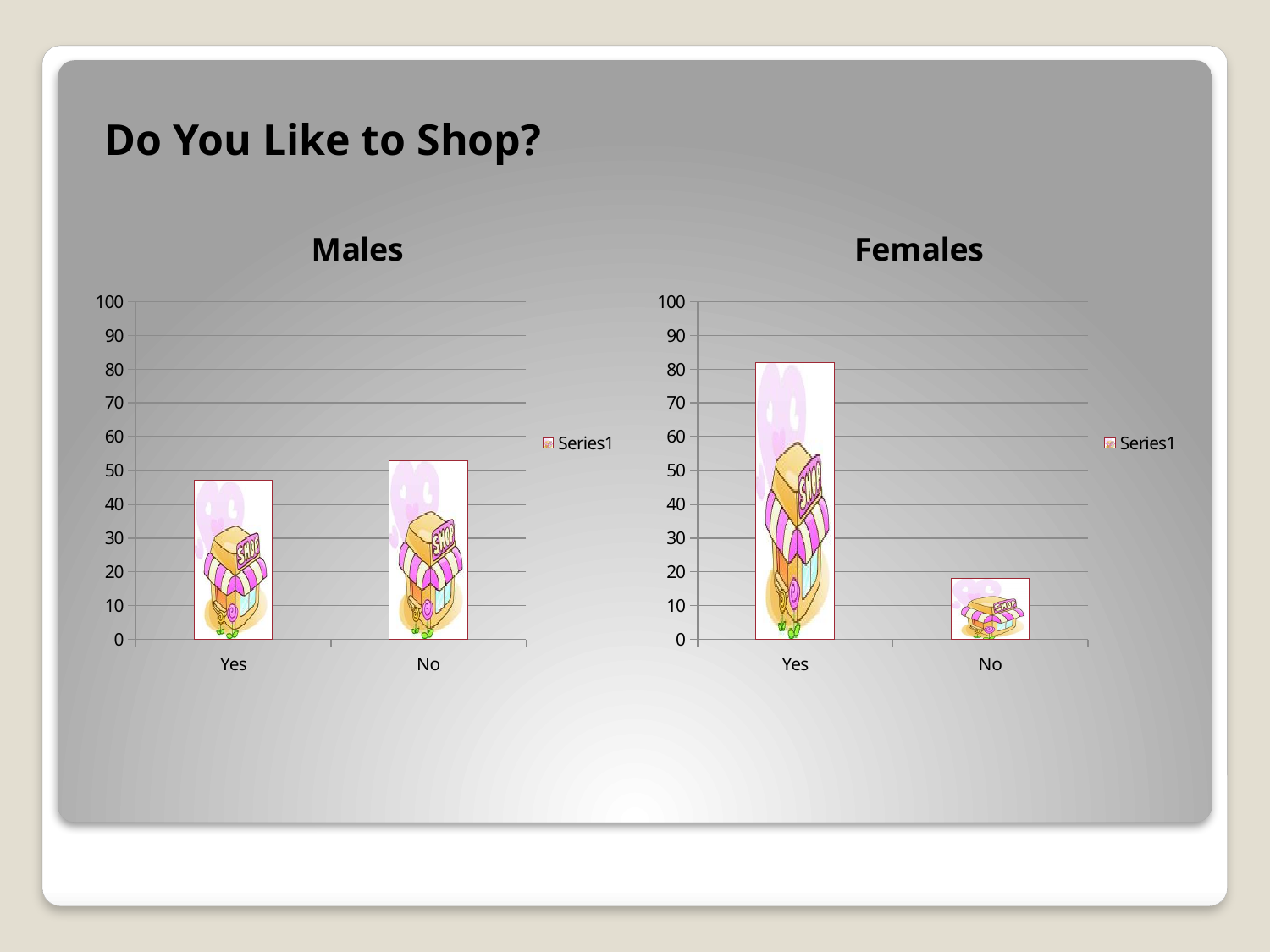
On the Females chart, which category has the lowest value? No What kind of chart is the Females chart? bar chart On the Males chart, is the value for No greater or less than 40? greater On the Females chart, which is larger, the value for Yes or the value for No? Yes On the Females chart, is the value for Yes greater or less than 70? greater On the Females chart, is the value for No greater or less than 30? less On the Females chart, which category has the highest value? Yes How many categories are shown on the Males chart? 2 How many series does the legend of the Males chart list? 1 What is the maximum value shown on the y axis of the Females chart? 100 What is the title of the chart on the left of the slide? Males